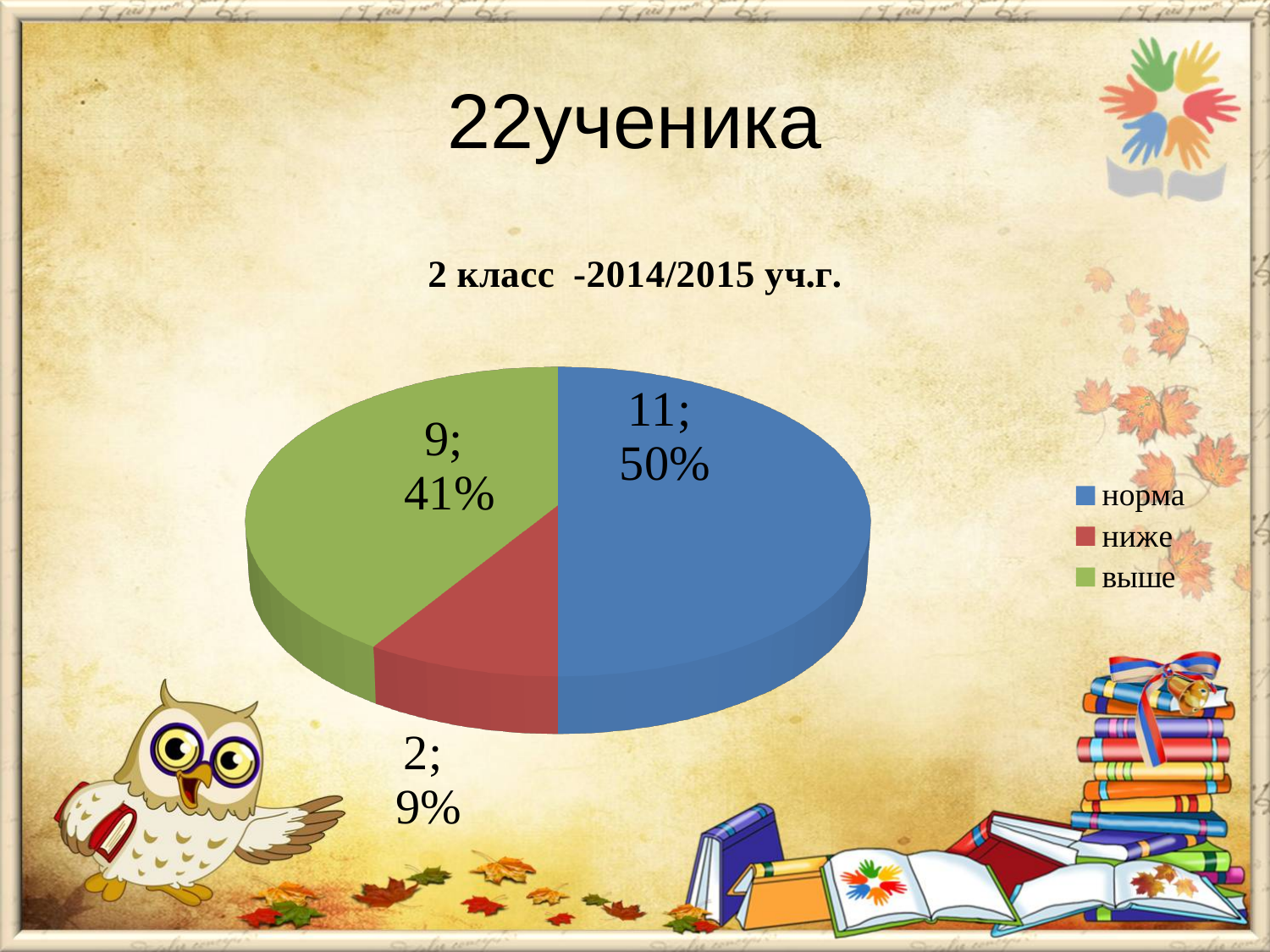
Which category has the largest slice? норма How many slices does the pie chart have? 3 How many entries does the legend list? 3 What is the value for the "ниже" slice? 2 What is the value for the "выше" slice? 9 What share of the pie does the "выше" slice represent? 41% Which category has the smallest slice? ниже What is the title of the chart? 2 класс -2014/2015 уч.г. What share of the pie does the "ниже" slice represent? 9% What kind of chart is shown on the slide? pie chart What is the value for the "норма" slice? 11 What is the difference between the values for "норма" and "выше"? 2